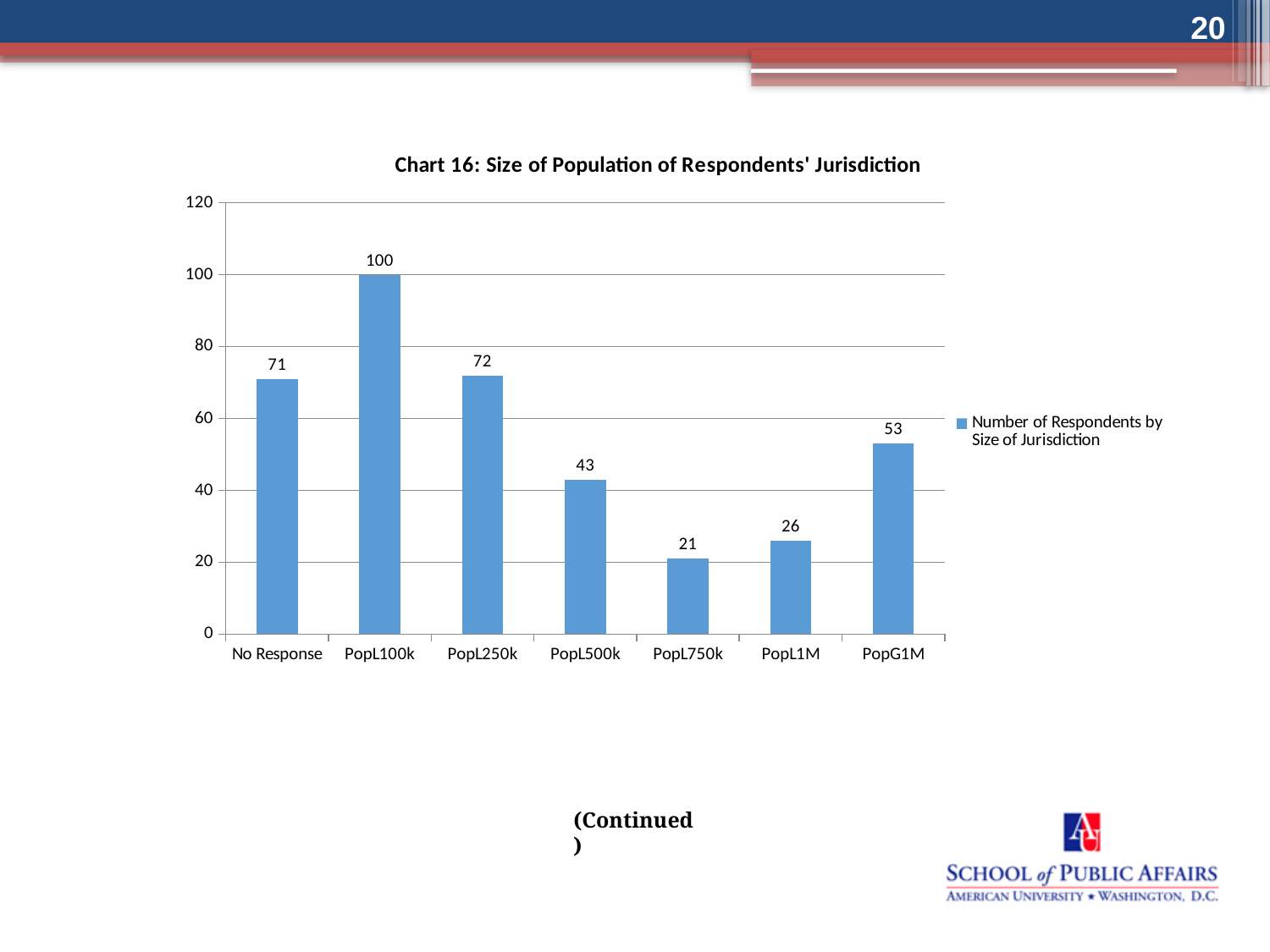
How many categories are shown on the x axis? 7 What is the difference between the values for PopL100k and PopL250k? 28 What kind of chart is shown? bar chart What is the value for PopL750k? 21 What is the value for No Response? 71 What is the value for PopL100k? 100 How many series does the legend list? 1 Is the value for PopL1M greater or less than 40? less Which is larger, the value for PopL500k or the value for PopG1M? PopG1M Which category has the highest value? PopL100k What is the title of the chart? Chart 16: Size of Population of Respondents' Jurisdiction Which category has the lowest value? PopL750k